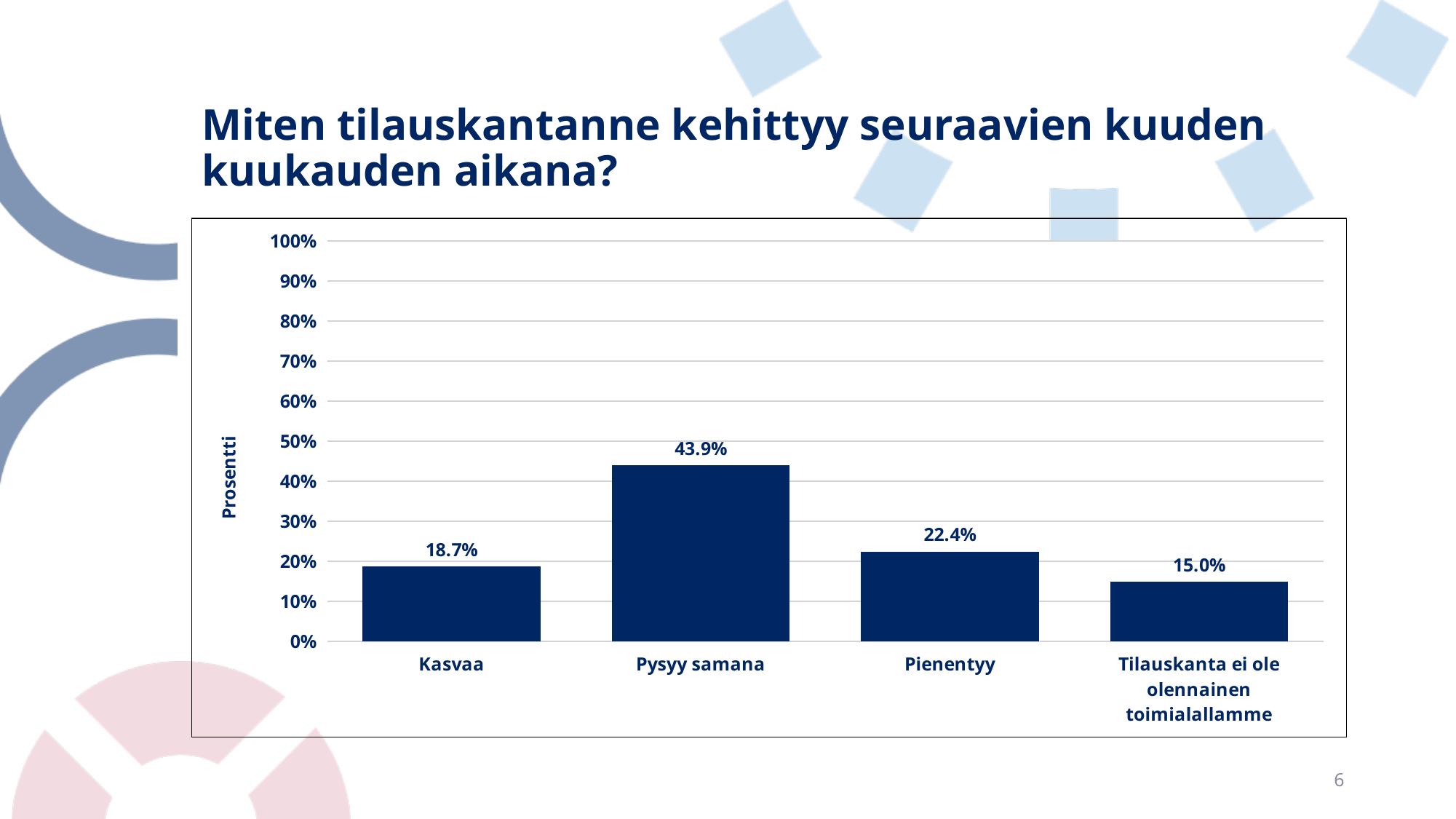
Which category has the highest value? Pysyy samana Which category has the lowest value? Tilauskanta ei ole olennainen toimialallamme What is the value for Tilauskanta ei ole olennainen toimialallamme? 15.0% What is the value for Pysyy samana? 43.9% What kind of chart is shown on the slide? Bar chart What is the value for Kasvaa? 18.7% Which is larger, the value for Kasvaa or the value for Pienentyy? Pienentyy What is the label of the y axis? Prosentti What is the difference between the values for Pysyy samana and Pienentyy? 21.5% How many categories are shown on the x axis? 4 What is the value for Pienentyy? 22.4% Is the value for Pysyy samana greater or less than 40%? greater